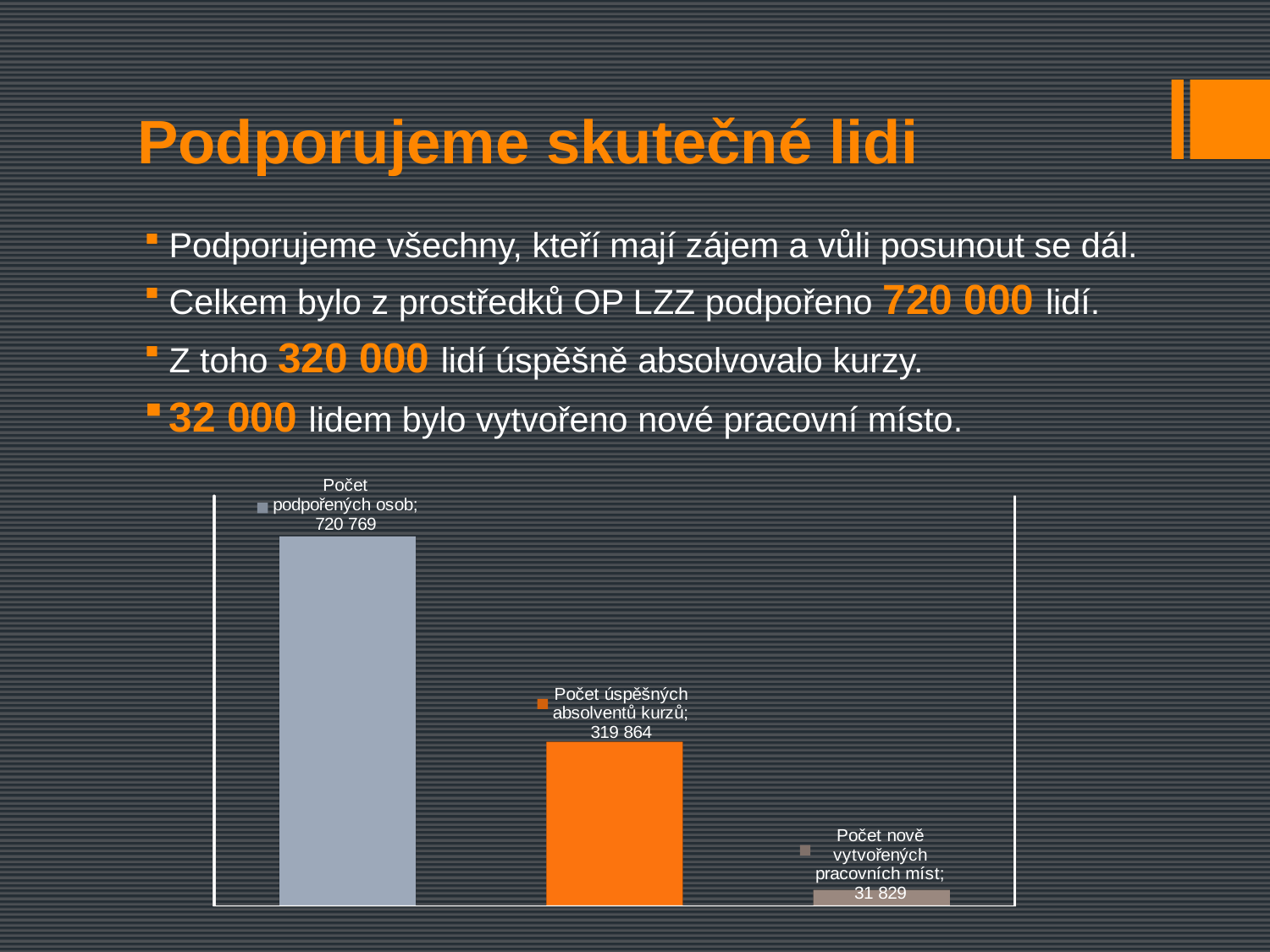
What is the difference between the values for "Počet podpořených osob" and "Počet úspěšných absolventů kurzů"? 400 905 What value is shown for "Počet úspěšných absolventů kurzů"? 319 864 Which category has the highest value in the chart? Počet podpořených osob How many bars are plotted in the chart? 3 Which is larger: the value for "Počet úspěšných absolventů kurzů" or the value for "Počet nově vytvořených pracovních míst"? Počet úspěšných absolventů kurzů What colour is the bar for "Počet úspěšných absolventů kurzů"? Orange Which category has the lowest value in the chart? Počet nově vytvořených pracovních míst What is the difference between the values for "Počet úspěšných absolventů kurzů" and "Počet nově vytvořených pracovních míst"? 288 035 What value is shown for "Počet podpořených osob"? 720 769 What value is shown for "Počet nově vytvořených pracovních míst"? 31 829 Do the bar values rise or fall from left to right across the chart? Fall What kind of chart is shown on the slide? Bar chart